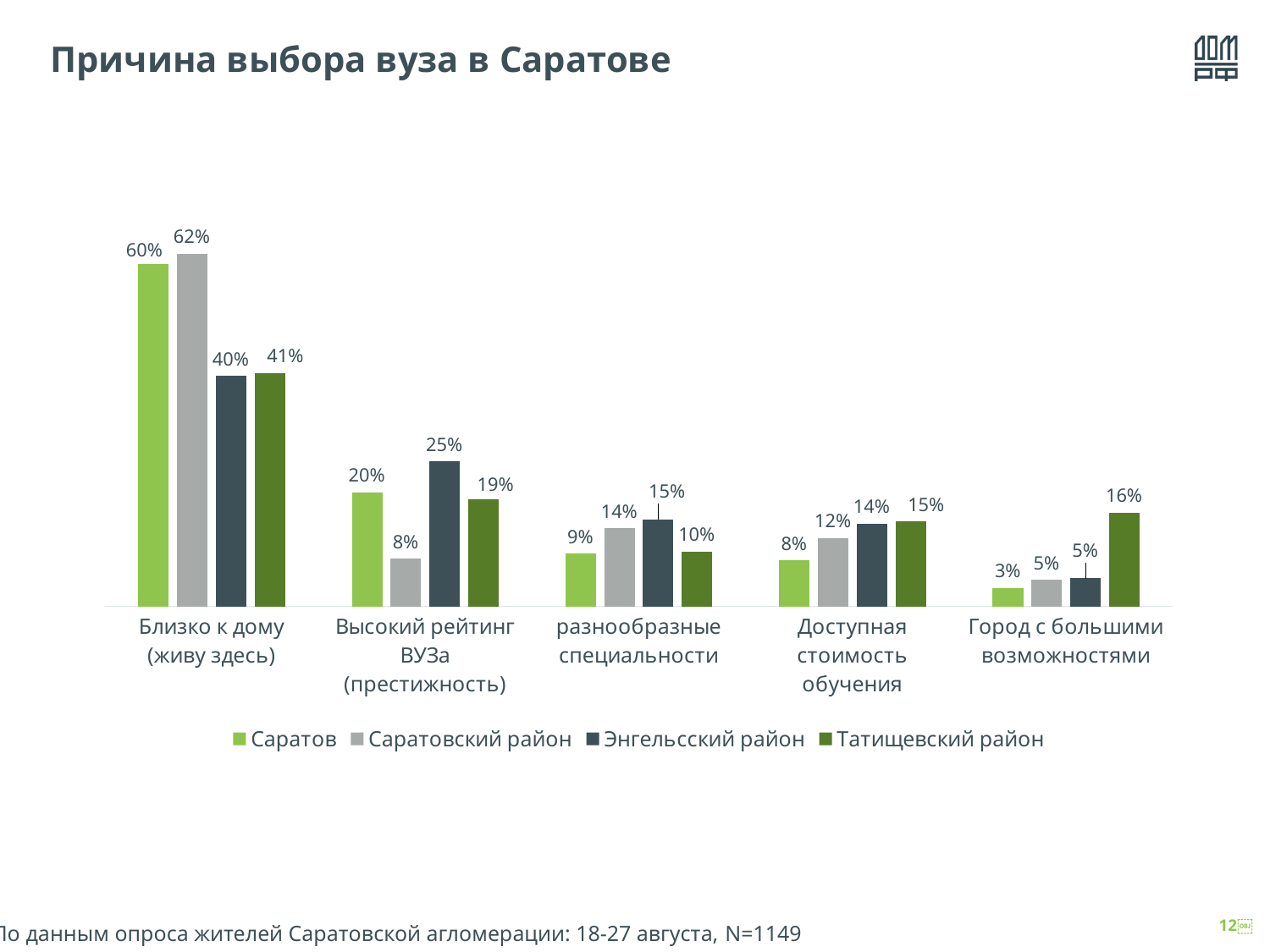
What is the difference between Саратовский район and Саратов in the category 'Доступная стоимость обучения'? 4% What is the title of the chart? Причина выбора вуза в Саратове What kind of chart is shown on the slide? Bar chart How many series does the legend list? 4 Which series has the highest value in the category 'Близко к дому (живу здесь)'? Саратовский район Which series has the lowest value in the category 'Высокий рейтинг ВУЗа (престижность)'? Саратовский район What is the value for Энгельсский район in the category 'Высокий рейтинг ВУЗа (престижность)'? 25% What is the value for Татищевский район in the category 'Город с большими возможностями'? 16% What is the value for Саратов in the category 'Близко к дому (живу здесь)'? 60% Which is larger in the category 'разнообразные специальности': Саратов or Саратовский район? Саратовский район How many categories are shown on the x axis? 5 What is the value for Саратов in the category 'Город с большими возможностями'? 3%